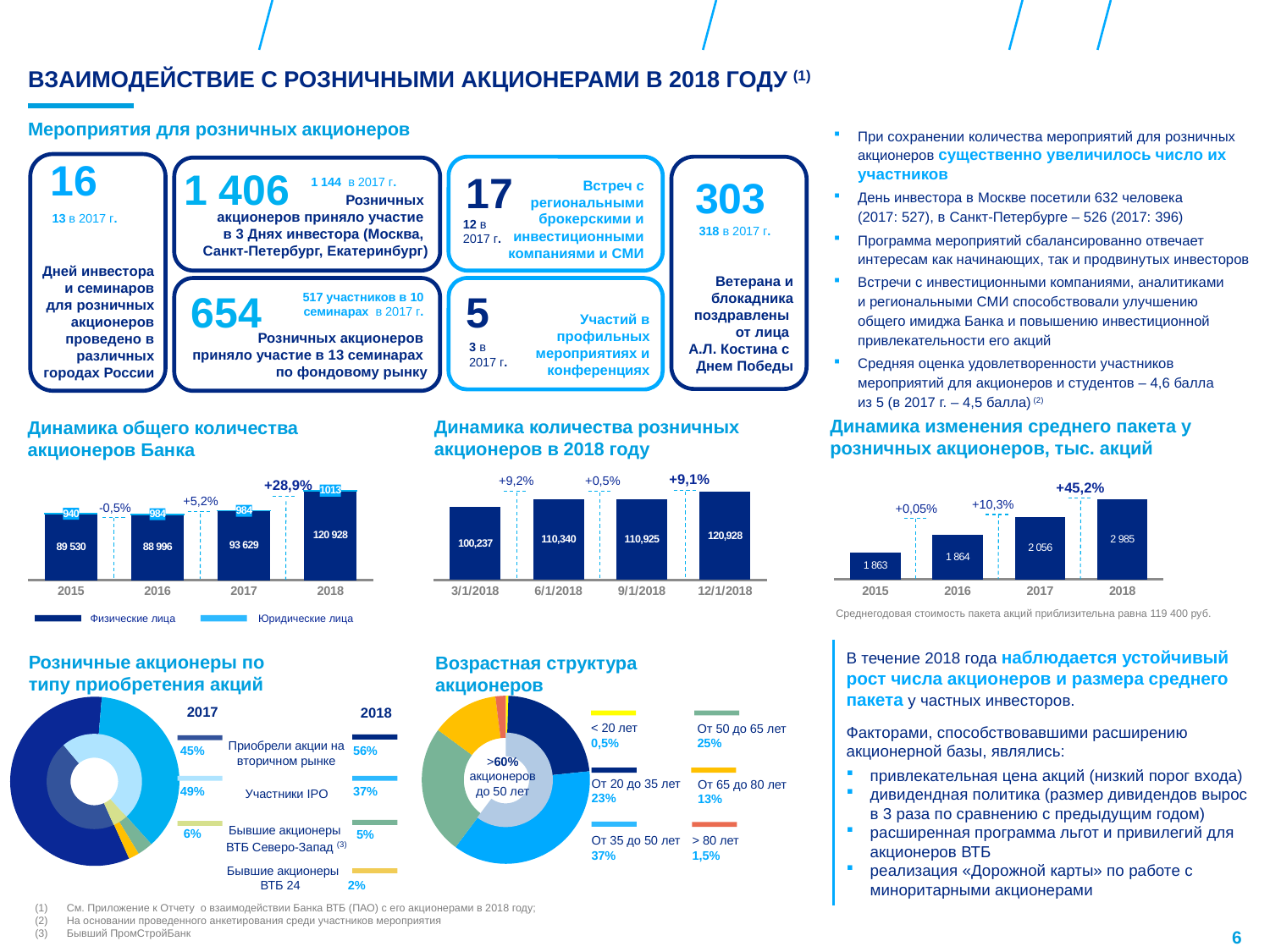
On the chart 'Розничные акционеры по типу приобретения акций', what is the 2018 share for Участники IPO? 37% On the chart 'Динамика изменения среднего пакета у розничных акционеров, тыс. акций', do the values rise or fall from 2015 to 2018? rise On the chart 'Динамика общего количества акционеров Банка', what is the value for Физические лица in 2018? 120 928 On the chart 'Динамика количества розничных акционеров в 2018 году', what is the value for 6/1/2018? 110,340 On the chart 'Динамика количества розничных акционеров в 2018 году', which date has the highest value? 12/1/2018 On the chart 'Динамика общего количества акционеров Банка', what is the value for Юридические лица in 2015? 940 On the chart 'Динамика общего количества акционеров Банка', how many series does the legend list? 2 On the chart 'Возрастная структура акционеров', what is the share for От 35 до 50 лет? 37% On the chart 'Динамика изменения среднего пакета у розничных акционеров, тыс. акций', what is the difference between the 2018 and 2017 values? 929 On the chart 'Динамика изменения среднего пакета у розничных акционеров, тыс. акций', what is the value for 2017? 2 056 On the chart 'Возрастная структура акционеров', which age group has the smallest share? < 20 лет On the chart 'Динамика количества розничных акционеров в 2018 году', how many dates are shown on the x axis? 4